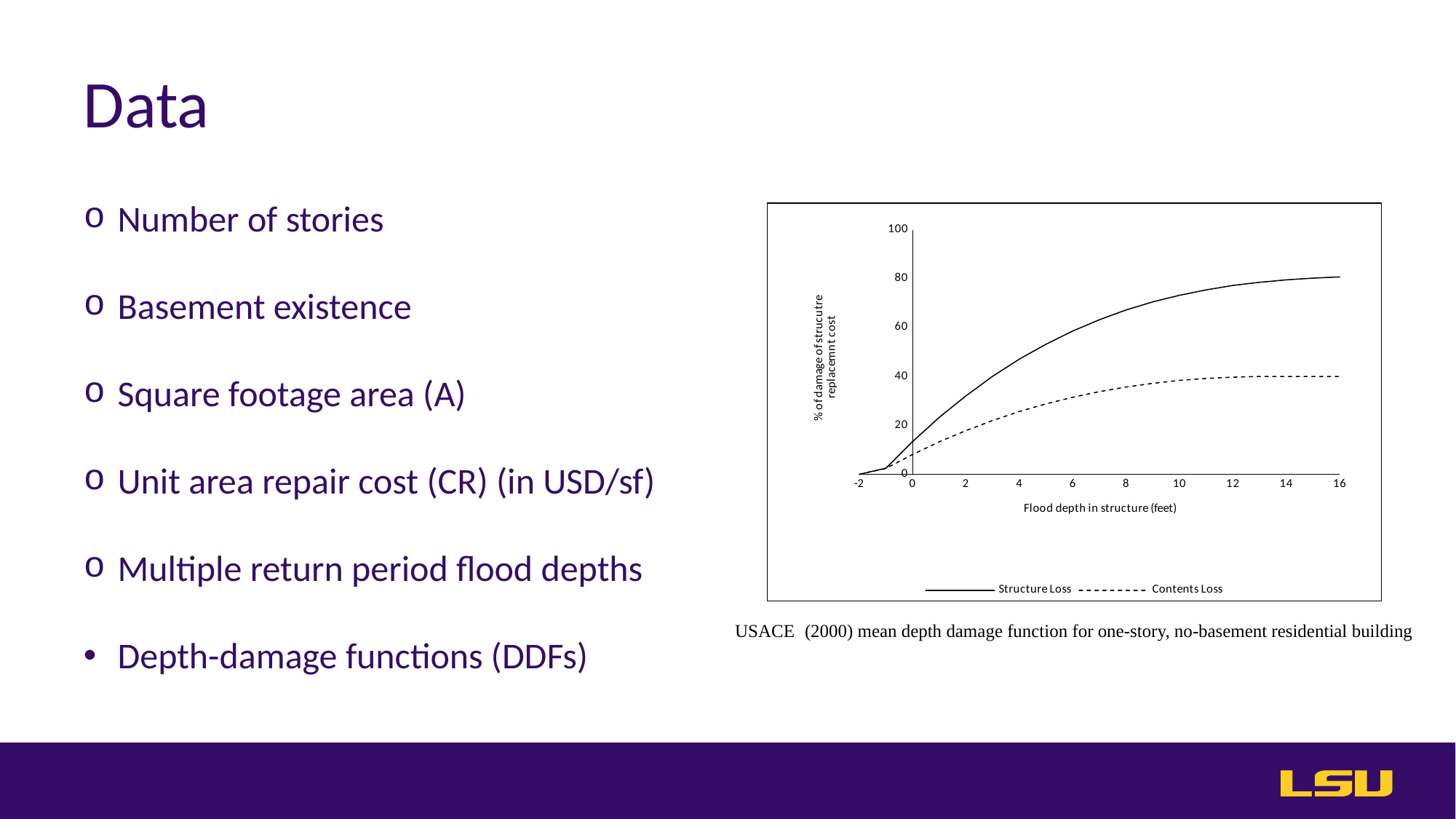
At a flood depth of 8 feet, which series has the larger value, Structure Loss or Contents Loss? Structure Loss What kind of chart is shown on the slide? line chart Do the Contents Loss values rise or fall as flood depth increases from 0 to 16 feet? rise Is the Structure Loss value at a flood depth of 2 feet greater or less than 20? greater Is the Structure Loss value at a flood depth of 10 feet greater or less than 60? greater What is the title of the x axis of the chart? Flood depth in structure (feet) Do the Structure Loss values rise or fall as flood depth increases along the x axis? rise Which series is drawn with a dashed line in the chart? Contents Loss Is the Contents Loss value at a flood depth of 16 feet greater or less than 60? less How many series does the chart's legend list? 2 Which series reaches the highest value on the chart? Structure Loss